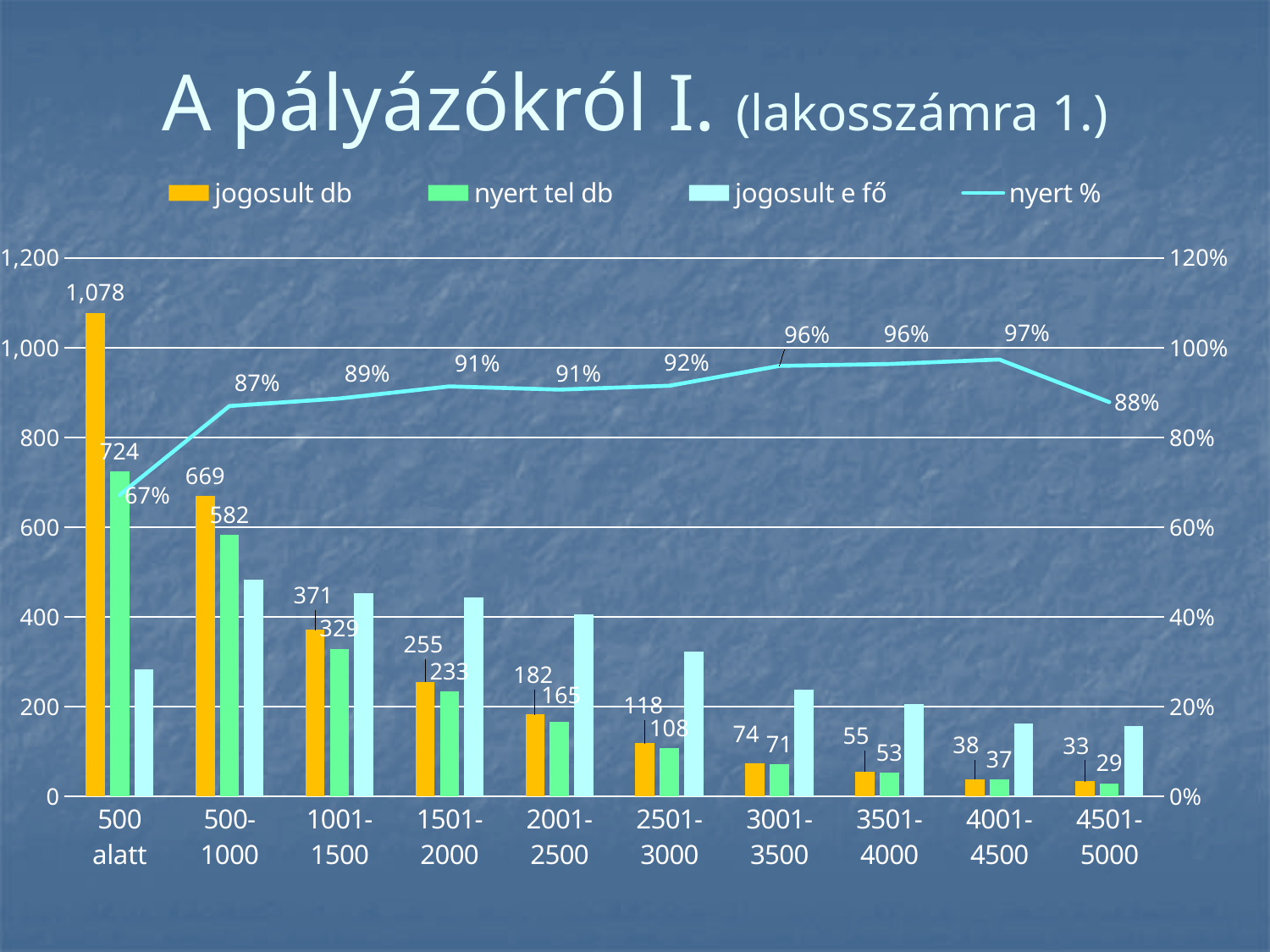
What is the value of nyert tel db for the 3501-4000 category? 53 Which category has the highest nyert % value? 4001-4500 Which category has the lowest nyert % value? 500 alatt What is the nyert % value for the 4501-5000 category? 88% Which is larger: jogosult db for 1501-2000 or nyert tel db for 1001-1500? nyert tel db for 1001-1500 How many categories are shown on the x axis? 10 How many series does the legend list? 4 What is the value of nyert tel db for the 1001-1500 category? 329 What kind of chart is shown on the slide? Combination bar and line chart What is the value of jogosult db for the 500 alatt category? 1,078 Is the value of jogosult e fő for the 500-1000 category greater or less than 400? greater What is the difference between jogosult db and nyert tel db for the 500-1000 category? 87